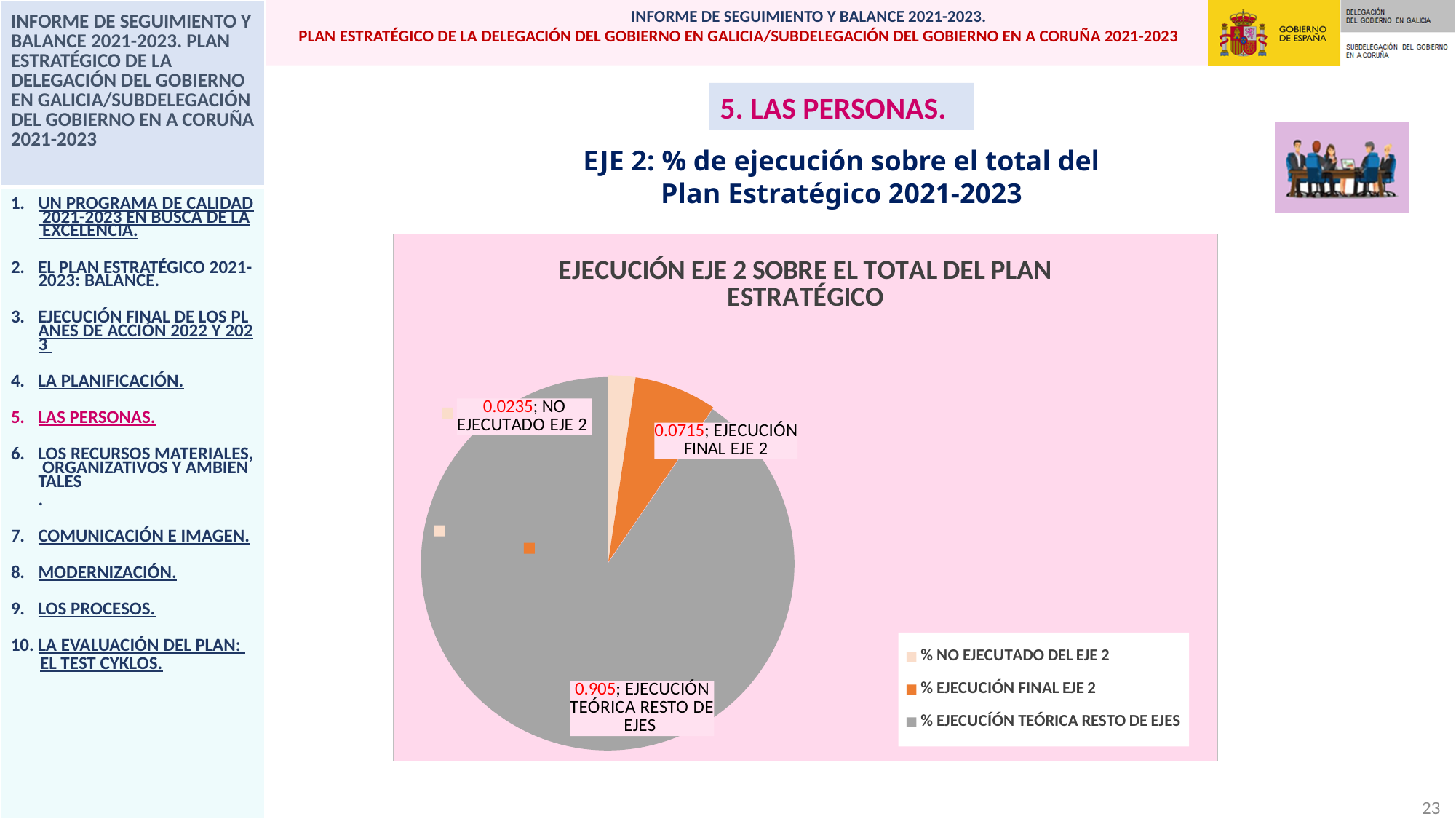
Which slice of the pie chart is the largest? EJECUCIÓN TEÓRICA RESTO DE EJES Which is larger: EJECUCIÓN FINAL EJE 2 or NO EJECUTADO EJE 2? EJECUCIÓN FINAL EJE 2 How many slices does the pie chart have? 3 What is the value of the EJECUCIÓN FINAL EJE 2 slice? 0.0715 Which slice of the pie chart is the smallest? NO EJECUTADO EJE 2 What is the value of the EJECUCIÓN TEÓRICA RESTO DE EJES slice? 0.905 What is the title of the chart? EJECUCIÓN EJE 2 SOBRE EL TOTAL DEL PLAN ESTRATÉGICO How many entries does the legend list? 3 What colour is the % EJECUCIÓN FINAL EJE 2 slice? orange What is the value of the NO EJECUTADO EJE 2 slice? 0.0235 What is the difference between the EJECUCIÓN FINAL EJE 2 value and the NO EJECUTADO EJE 2 value? 0.048 What type of chart is shown on the slide? pie chart